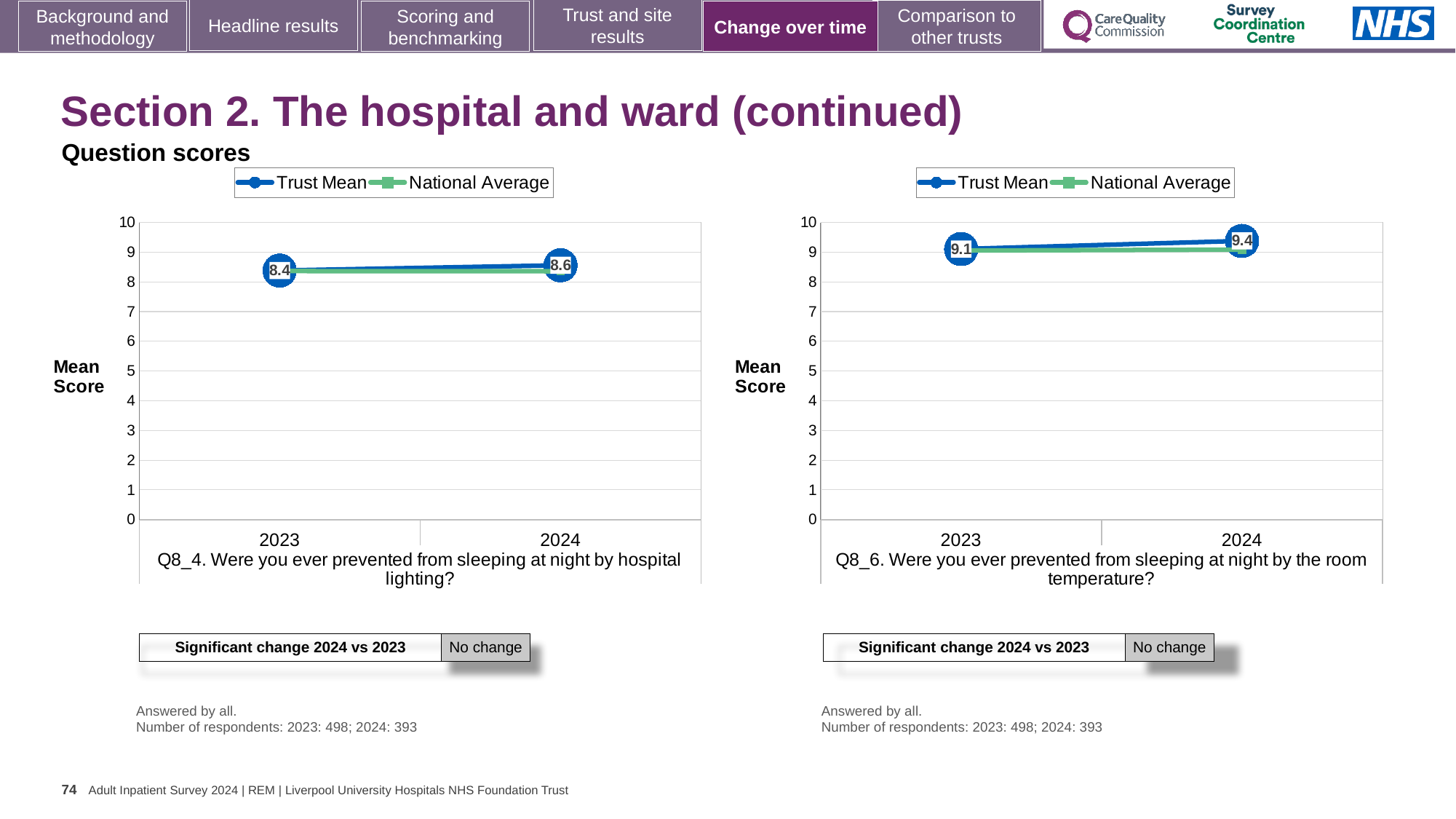
In the right chart (Q8_6, room temperature), by how much did the Trust Mean change from 2023 to 2024? 0.3 What type of chart is used on this slide? line chart In the right chart (Q8_6, room temperature), what is the Trust Mean for 2024? 9.4 In the left chart (Q8_4, hospital lighting), does the Trust Mean rise or fall from 2023 to 2024? rise In the right chart (Q8_6, room temperature), is the National Average for 2024 greater or less than 8? greater In the right chart (Q8_6, room temperature), does the Trust Mean rise or fall from 2023 to 2024? rise How many series does the legend of the left chart list? 2 In the right chart (Q8_6, room temperature), what is the Trust Mean for 2023? 9.1 In the left chart (Q8_4, hospital lighting), what is the Trust Mean for 2024? 8.6 How many years are shown on the x axis of the right chart? 2 In the left chart (Q8_4, hospital lighting), by how much did the Trust Mean change from 2023 to 2024? 0.2 In the left chart (Q8_4, hospital lighting), what is the Trust Mean for 2023? 8.4